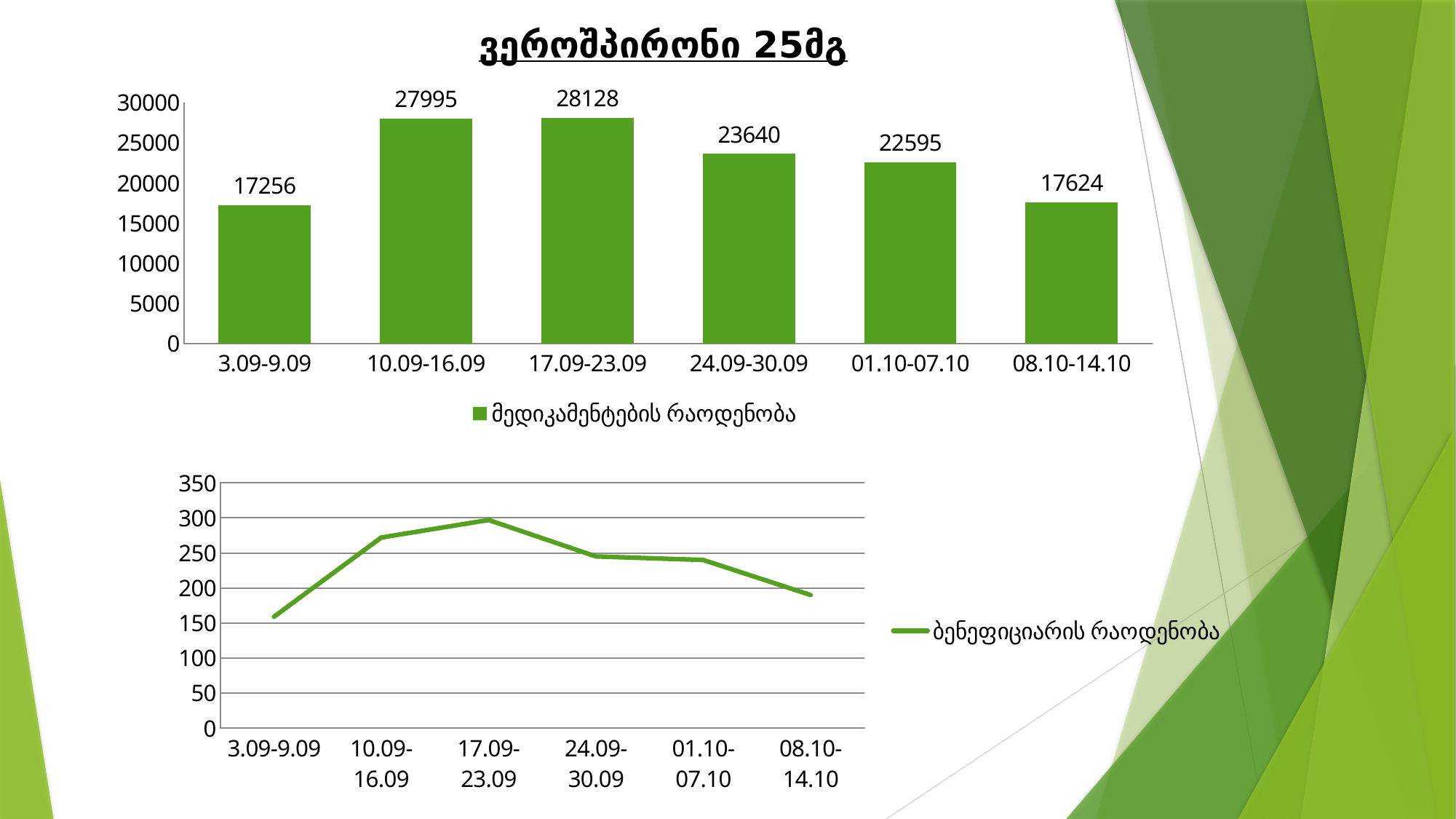
In the top bar chart titled ვეროშპირონი 25მგ, which period has the lowest value? 3.09-9.09 In the bottom line chart, is the value for 3.09-9.09 greater or less than 200? less How many periods are shown on the x axis of the top bar chart titled ვეროშპირონი 25მგ? 6 What kind of chart is the bottom chart on the slide? line chart In the bottom line chart, is the value for 17.09-23.09 greater or less than 250? greater In the top bar chart titled ვეროშპირონი 25მგ, what is the difference between the values for 17.09-23.09 and 24.09-30.09? 4488 In the top bar chart titled ვეროშპირონი 25მგ, which period has the highest value? 17.09-23.09 In the top bar chart titled ვეროშპირონი 25მგ, what is the value for 10.09-16.09? 27995 In the top bar chart titled ვეროშპირონი 25მგ, which is larger: the value for 24.09-30.09 or the value for 08.10-14.10? 24.09-30.09 What kind of chart is the top chart titled ვეროშპირონი 25მგ? bar chart In the top bar chart titled ვეროშპირონი 25მგ, what is the value for 01.10-07.10? 22595 What is the legend entry of the bottom line chart? ბენეფიციარის რაოდენობა